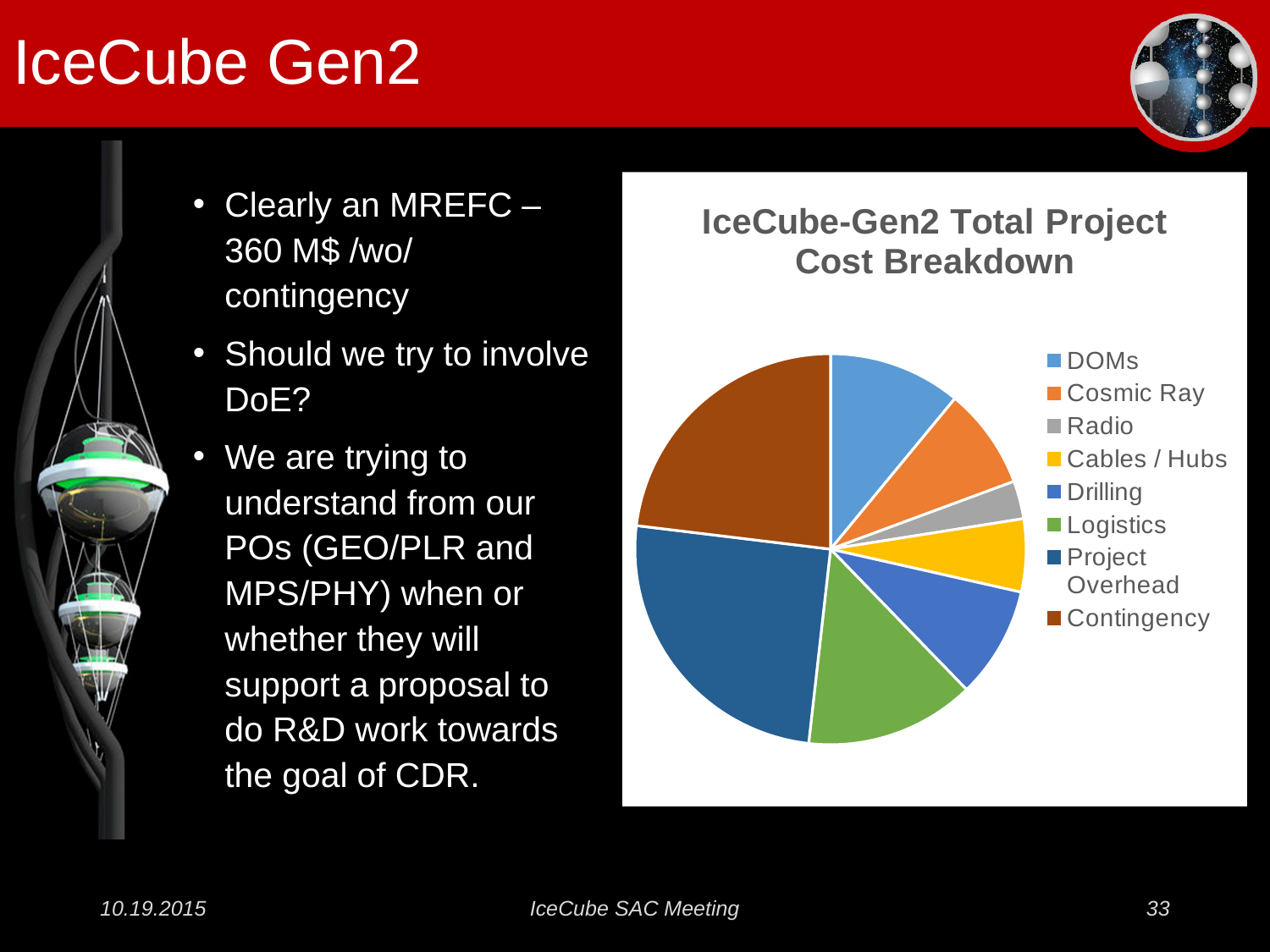
How many categories (slices) does the pie chart have? 8 Which slice is larger, Drilling or Cables / Hubs? Drilling Which category has the largest slice of the pie? Project Overhead Which slice is larger, Contingency or DOMs? Contingency Which slice is larger, Logistics or Radio? Logistics Which category has the smallest slice of the pie? Radio What is the title of the chart? IceCube-Gen2 Total Project Cost Breakdown What kind of chart is shown on the slide? Pie chart What colour is the Contingency slice in the pie chart? Brown